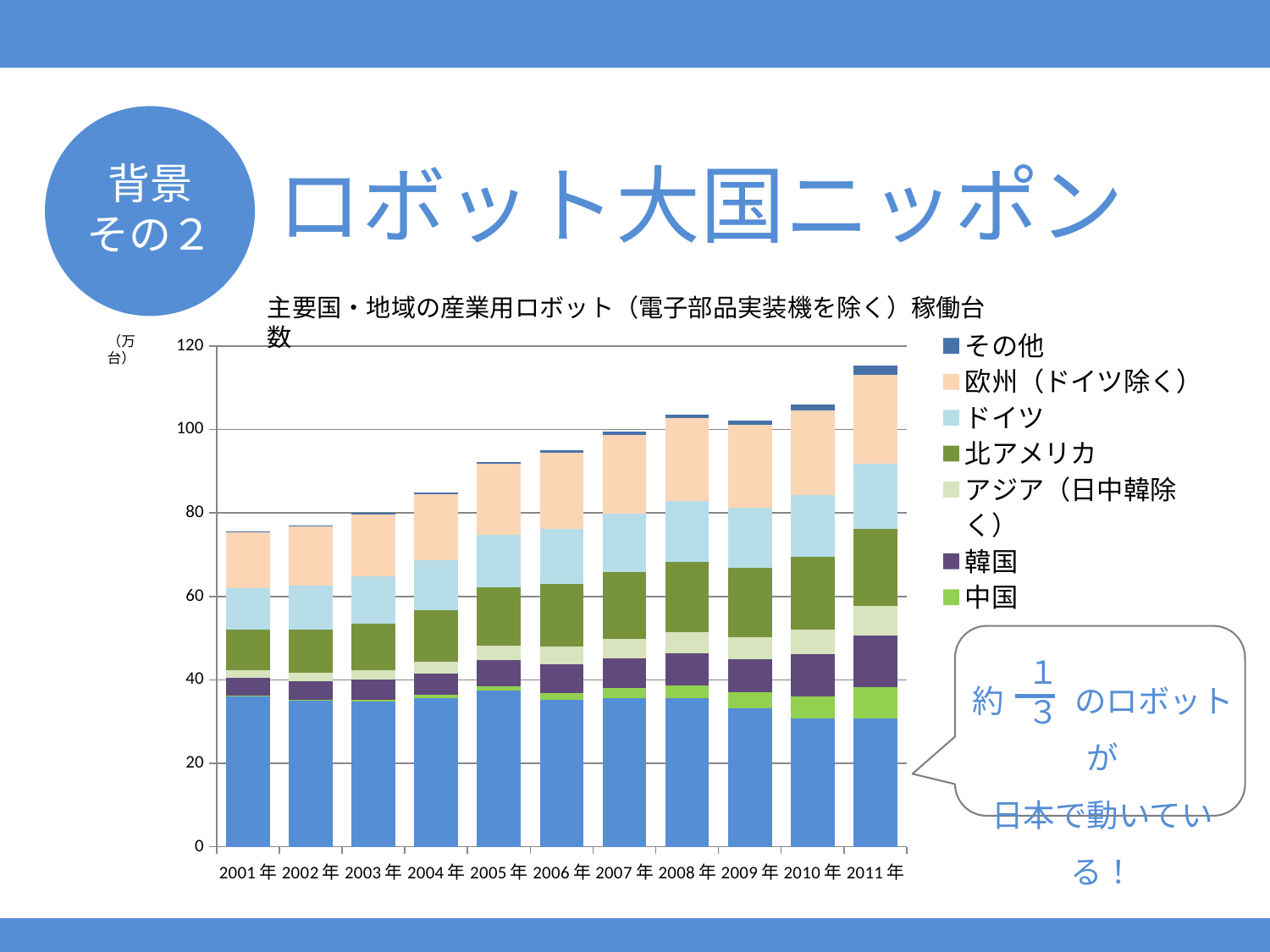
Is the total for 2001年 greater or less than 80? less Is the total for 2011年 greater or less than 100? greater What kind of chart is shown on the slide? Stacked bar chart What is the title of the chart? 主要国・地域の産業用ロボット（電子部品実装機を除く）稼働台数 How many series does the chart's legend list? 7 Is the total for 2010年 greater or less than 100? greater Which year has the highest total stacked bar? 2011年 What unit is shown at the top of the y axis? 万台 Which total is larger, 2001年 or 2011年? 2011年 How many years are shown on the x axis of the chart? 11 Do the total stacked bar heights generally rise or fall from 2001年 to 2011年? rise